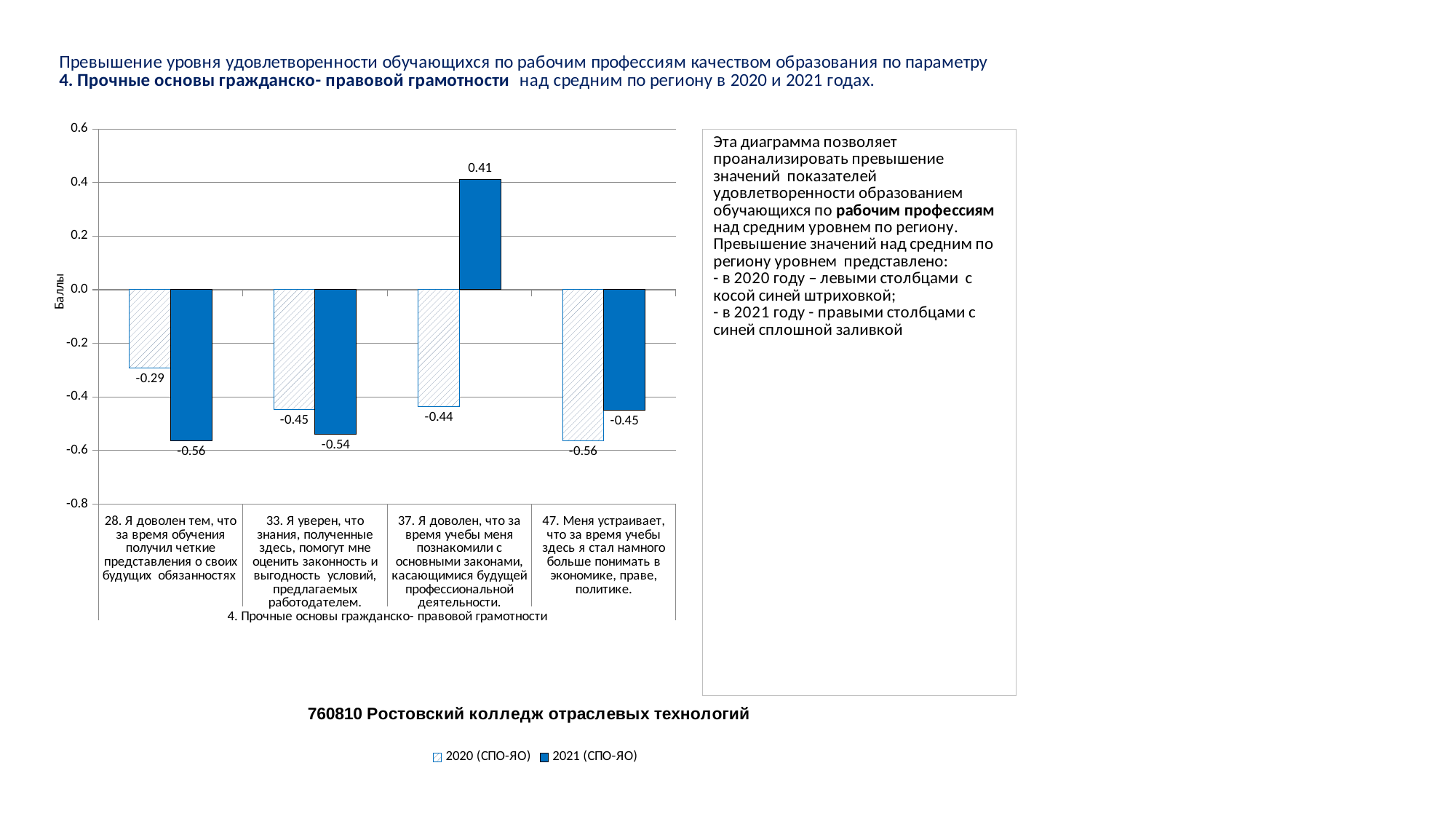
How many series does the legend list? 2 What is the label of the vertical axis of the chart? Баллы What is the difference between the 2021 (СПО-ЯО) and 2020 (СПО-ЯО) values for category 37? 0.85 What is the value for 2021 (СПО-ЯО) for category 47 (Меня устраивает, что за время учебы здесь я стал намного больше понимать в экономике, праве, политике)? -0.45 For category 28, which series has the larger value: 2020 (СПО-ЯО) or 2021 (СПО-ЯО)? 2020 (СПО-ЯО) What is the value for 2020 (СПО-ЯО) for category 28 (Я доволен тем, что за время обучения получил четкие представления о своих будущих обязанностях)? -0.29 What is the value for 2020 (СПО-ЯО) for category 33 (Я уверен, что знания, полученные здесь, помогут мне оценить законность и выгодность условий...)? -0.45 What kind of chart is shown on the slide? Bar chart Which category has the highest value for the 2021 (СПО-ЯО) series? 37. Я доволен, что за время учебы меня познакомили с основными законами, касающимися будущей профессиональной деятельности. What is the value for 2021 (СПО-ЯО) for category 37 (Я доволен, что за время учебы меня познакомили с основными законами...)? 0.41 Which category has the lowest value for the 2020 (СПО-ЯО) series? 47. Меня устраивает, что за время учебы здесь я стал намного больше понимать в экономике, праве, политике. How many categories (questions) are shown on the x axis of the chart? 4